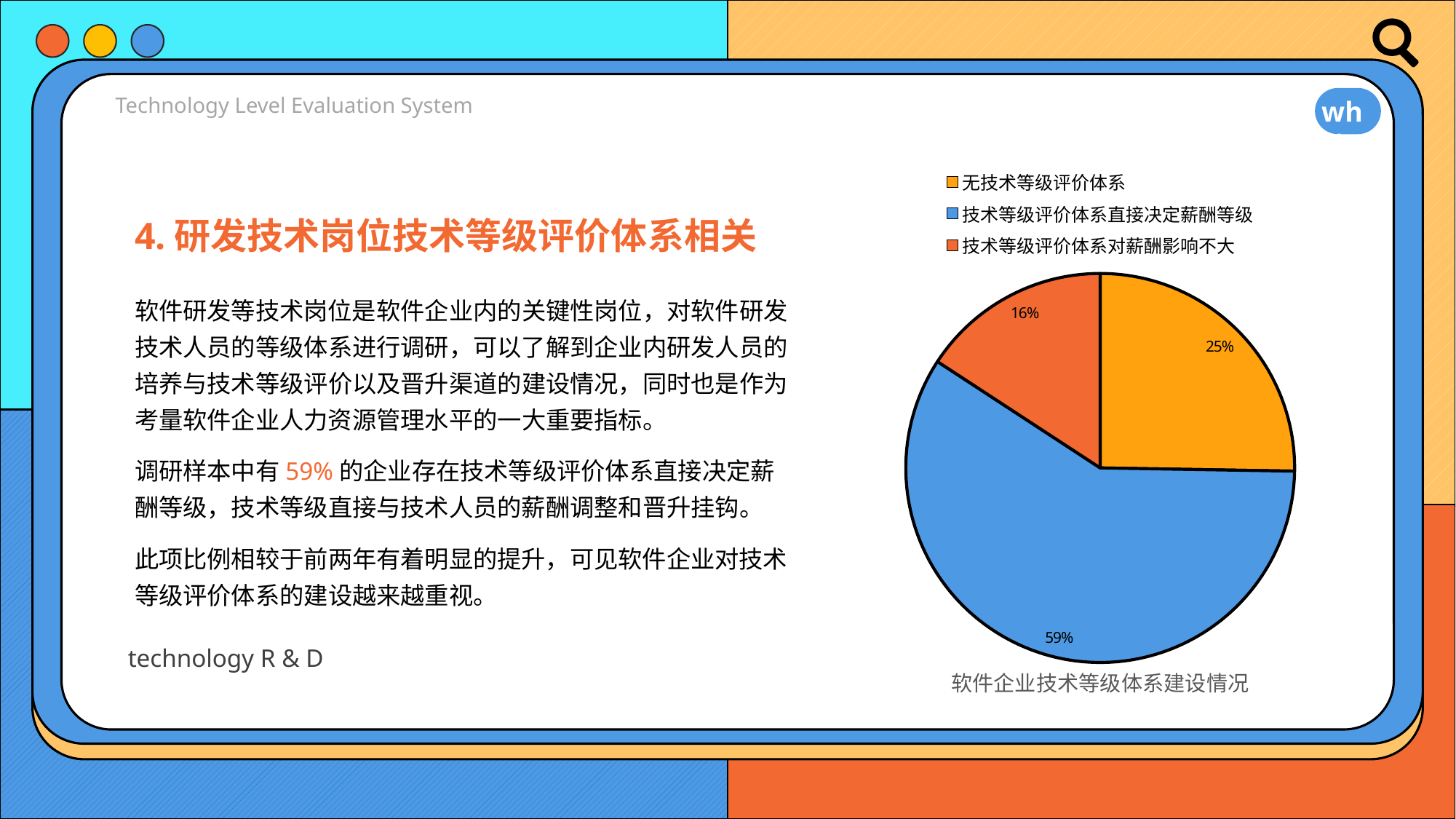
Which is larger, the share of 无技术等级评价体系 or the share of 技术等级评价体系对薪酬影响不大? 无技术等级评价体系 What type of chart is shown on the slide? pie chart Which category has the largest slice of the pie? 技术等级评价体系直接决定薪酬等级 What share of the pie does 技术等级评价体系直接决定薪酬等级 have? 59% What share of the pie does 技术等级评价体系对薪酬影响不大 have? 16% What is the difference between the shares of 技术等级评价体系直接决定薪酬等级 and 无技术等级评价体系? 34% How many slices does the pie chart have? 3 What is the title shown below the pie chart? 软件企业技术等级体系建设情况 What share of the pie does 无技术等级评价体系 have? 25% Which category has the smallest slice of the pie? 技术等级评价体系对薪酬影响不大 What colour is the slice for 技术等级评价体系直接决定薪酬等级? blue What is the difference between the shares of 无技术等级评价体系 and 技术等级评价体系对薪酬影响不大? 9%